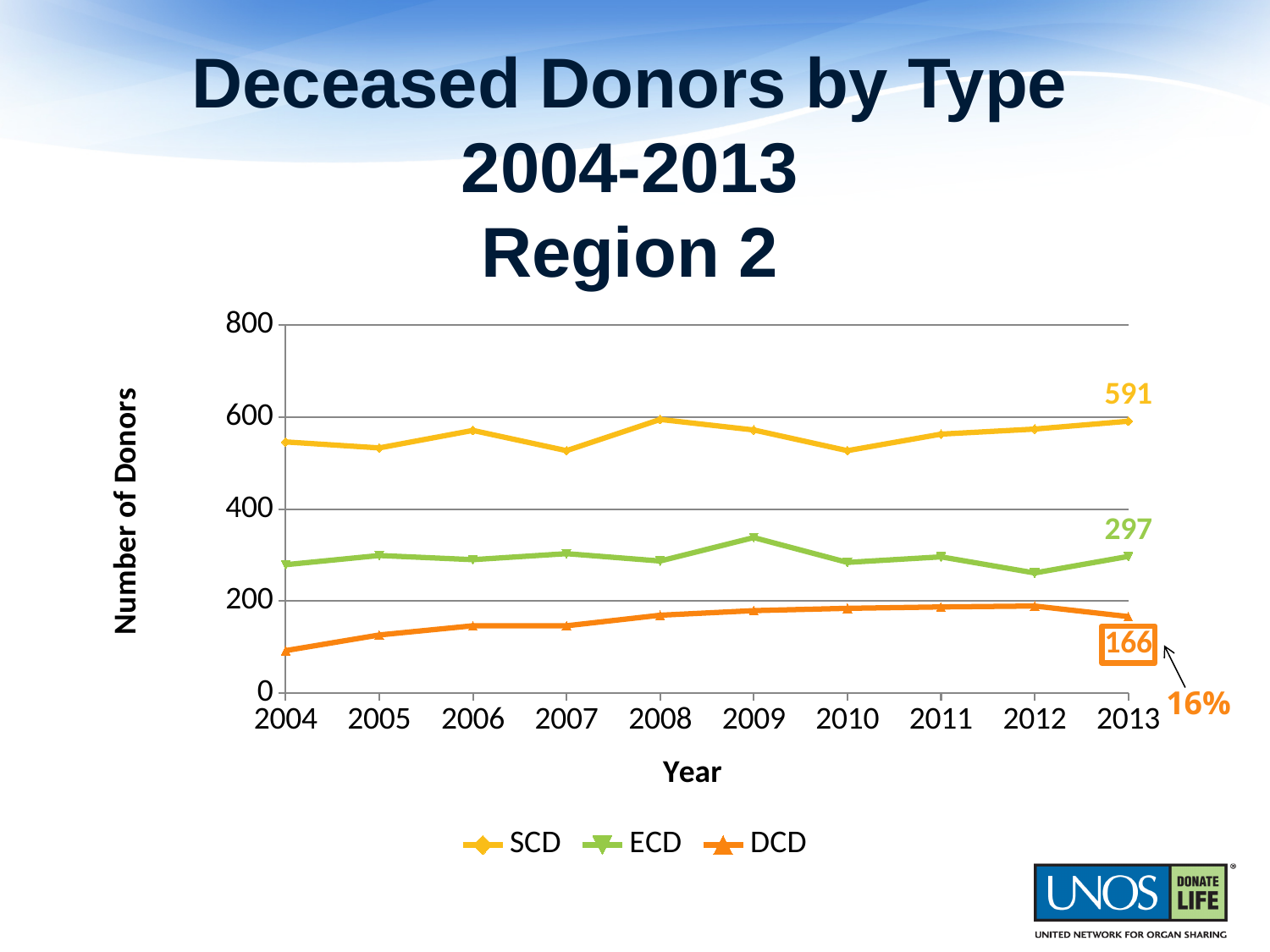
Is the value for SCD in 2008 greater or less than 400? greater What is the difference between the ECD and DCD values in 2013? 131 What is the value for DCD in 2013? 166 How many series does the legend list? 3 Is the value for DCD in 2004 greater or less than 200? less What is the value for ECD in 2013? 297 How many years are shown on the x axis? 10 What kind of chart is shown on the slide? line chart In which year is the DCD series at its lowest? 2004 Which series has the highest value in 2013? SCD What is the value for SCD in 2013? 591 What is the difference between the SCD and ECD values in 2013? 294